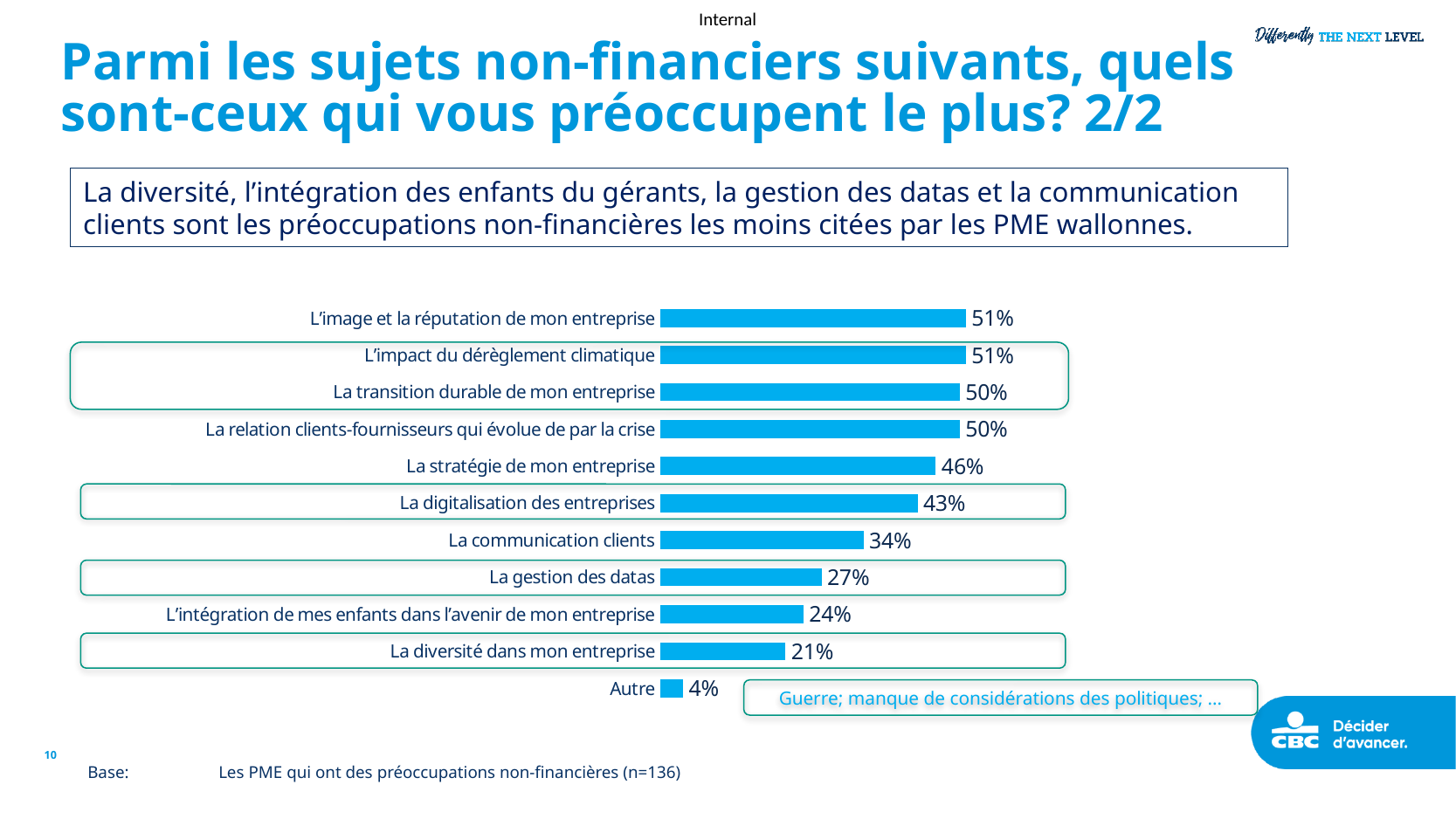
What is the base (n) stated for the chart? n=136 What is the value for "La stratégie de mon entreprise"? 46% Which is larger: "La transition durable de mon entreprise" or "L'intégration de mes enfants dans l'avenir de mon entreprise"? La transition durable de mon entreprise What is the value for "La diversité dans mon entreprise"? 21% What is the difference between "L'image et la réputation de mon entreprise" and "La diversité dans mon entreprise"? 30% What kind of chart is shown on the slide? bar chart How many categories (bars) does the chart show? 11 What is the value for "Autre"? 4% What is the value for "La digitalisation des entreprises"? 43% What is the difference between "La communication clients" and "La gestion des datas"? 7% Which category has the lowest value? Autre What is the value for "La gestion des datas"? 27%